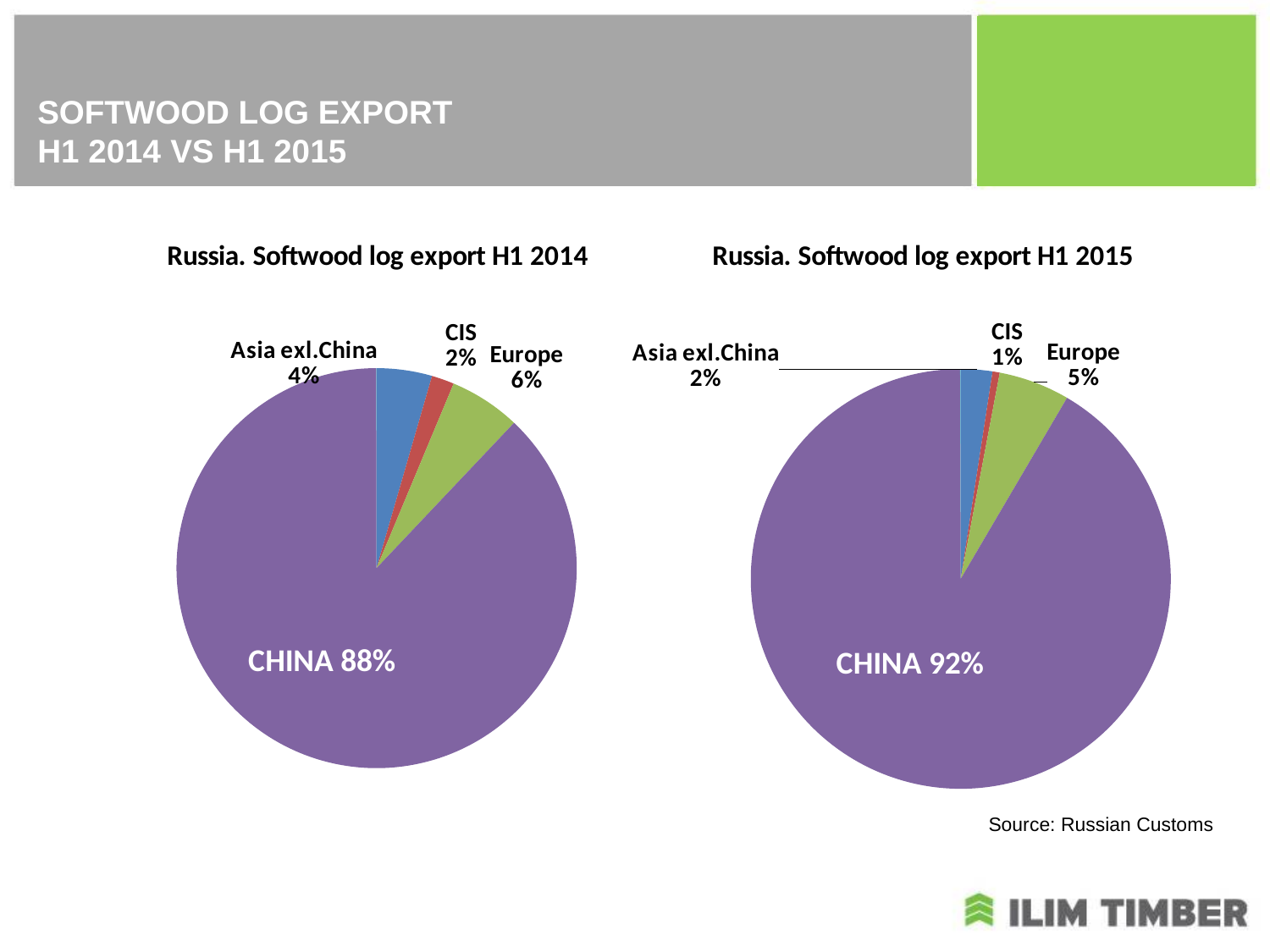
What is the difference between China's share in the H1 2015 chart and its share in the H1 2014 chart? 4% In the 'Russia. Softwood log export H1 2015' chart, what is the share for CIS? 1% In the 'Russia. Softwood log export H1 2014' chart, what is the share for Europe? 6% In the 'Russia. Softwood log export H1 2014' chart, which category has the smallest share? CIS In the 'Russia. Softwood log export H1 2014' chart, which category has the largest share? CHINA In the 'Russia. Softwood log export H1 2015' chart, which category has the smallest share? CIS In the 'Russia. Softwood log export H1 2015' chart, what share does China have? 92% In the 'Russia. Softwood log export H1 2014' chart, which is larger, the share for Europe or the share for Asia exl.China? Europe How many categories are shown in the 'Russia. Softwood log export H1 2015' chart? 4 What type of chart is used for 'Russia. Softwood log export H1 2014'? Pie chart In the 'Russia. Softwood log export H1 2015' chart, what is the share for Asia exl.China? 2% In the 'Russia. Softwood log export H1 2014' chart, what share does China have? 88%